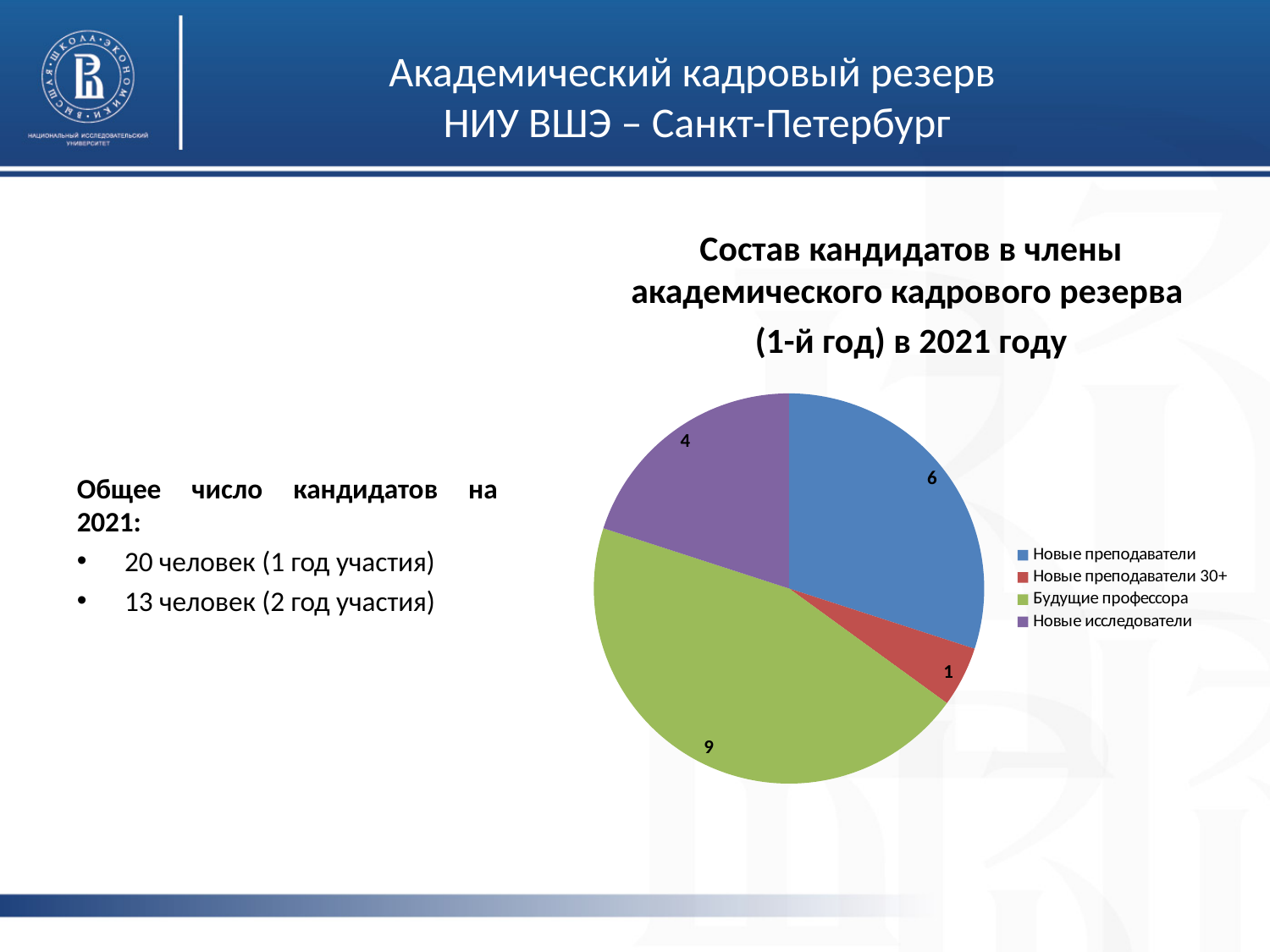
Which category has the smallest slice of the pie? Новые преподаватели 30+ What is the value for Новые преподаватели 30+? 1 What is the value for Будущие профессора? 9 What share of the pie does Будущие профессора represent? 45% What kind of chart is shown on the slide? pie chart What is the value for Новые преподаватели? 6 What is the value for Новые исследователи? 4 Which category has the largest slice of the pie? Будущие профессора What is the title of the pie chart? Состав кандидатов в члены академического кадрового резерва (1-й год) в 2021 году How many slices does the pie chart have? 4 Which is larger, the value for Новые преподаватели or the value for Новые исследователи? Новые преподаватели What is the difference between the values for Будущие профессора and Новые преподаватели? 3